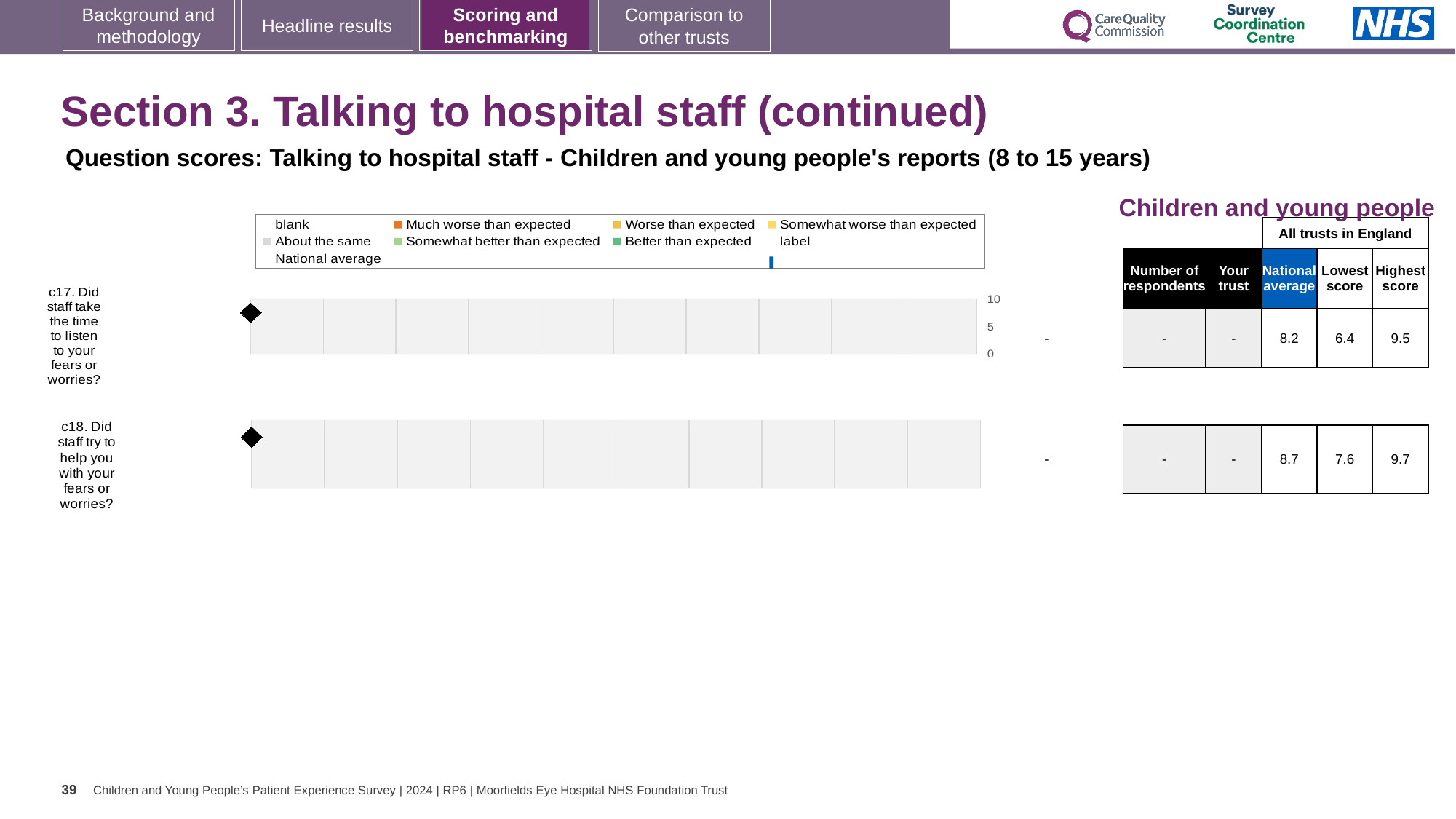
In the table beside the chart, what is the National average score for c17 (Did staff take the time to listen to your fears or worries?)? 8.2 What value is shown for 'Your trust' for c17 in the table? - Which question has the higher Lowest score in the table, c17 or c18? c18 What kind of chart is used for questions c17 and c18 on this slide? Bar chart What is the highest tick value shown on the score axis of the chart? 10 How many survey questions (categories) are plotted on the slide? 2 Which question has the higher National average score in the table, c17 or c18? c18 In the table beside the chart, what is the Lowest score for c18? 7.6 What is the difference between the Highest score and the Lowest score for c17 in the table? 3.1 What is the difference between the National average scores for c18 and c17 in the table? 0.5 What are the two survey question codes shown as categories on the chart? c17 and c18 In the table beside the chart, what is the Highest score for c18 (Did staff try to help you with your fears or worries?)? 9.7